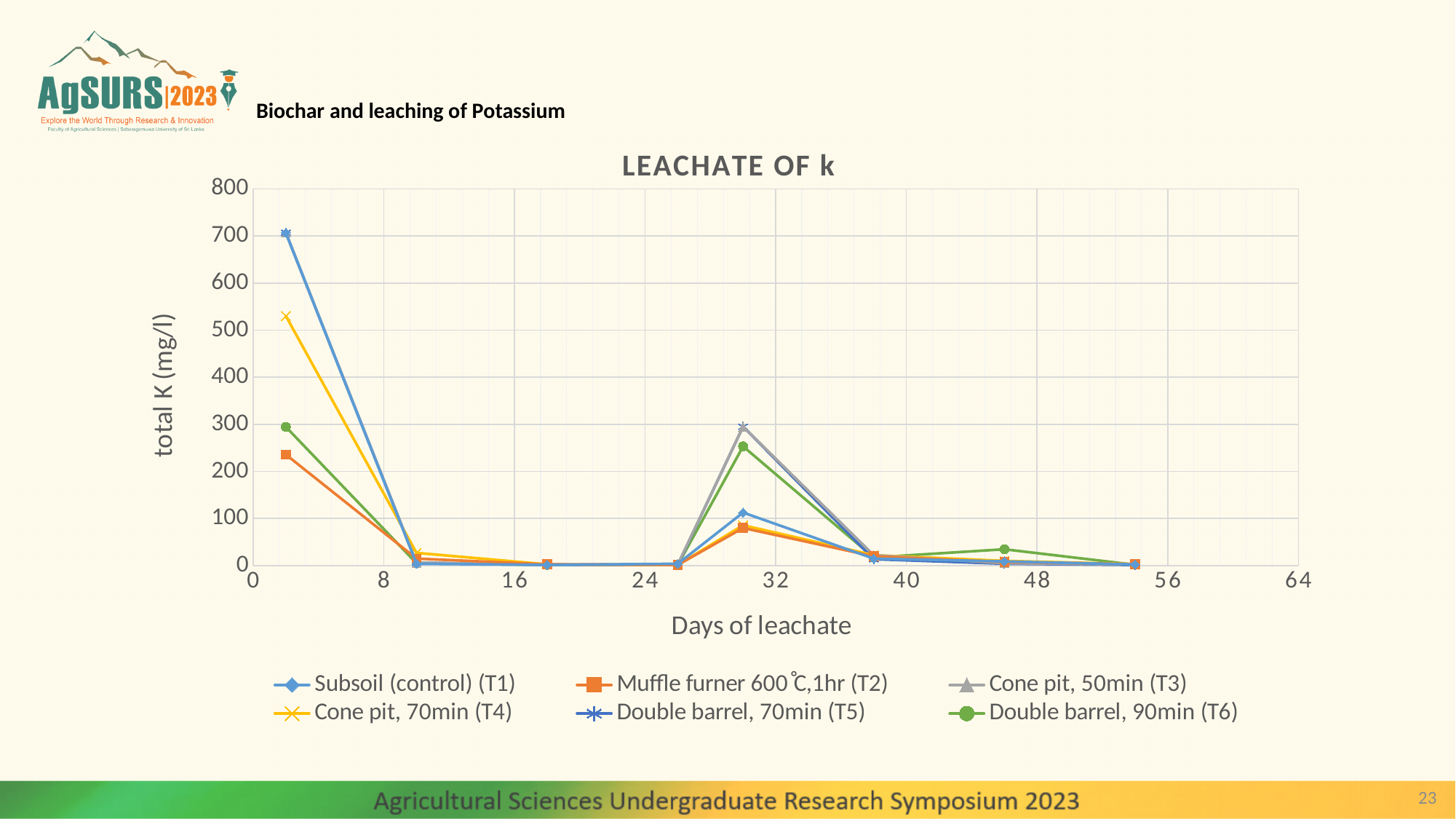
How many series does the legend of the chart list? 6 Is the value for Subsoil (control) (T1) around day 30 greater or less than 200? less Is the first plotted value for Double barrel, 90min (T6) greater or less than 200? greater Is the first plotted value for Muffle furner 600℃,1hr (T2) greater or less than 200? greater What is the label of the y axis of the chart? total K (mg/l) What kind of chart is shown on the slide? line chart What is the title of the chart? LEACHATE OF k Do the values for Cone pit, 70min (T4) rise or fall between the first and second plotted days? fall At the first plotted day, which is larger: Cone pit, 70min (T4) or Double barrel, 90min (T6)? Cone pit, 70min (T4) Around day 30, which is larger: Cone pit, 50min (T3) or Muffle furner 600℃,1hr (T2)? Cone pit, 50min (T3)